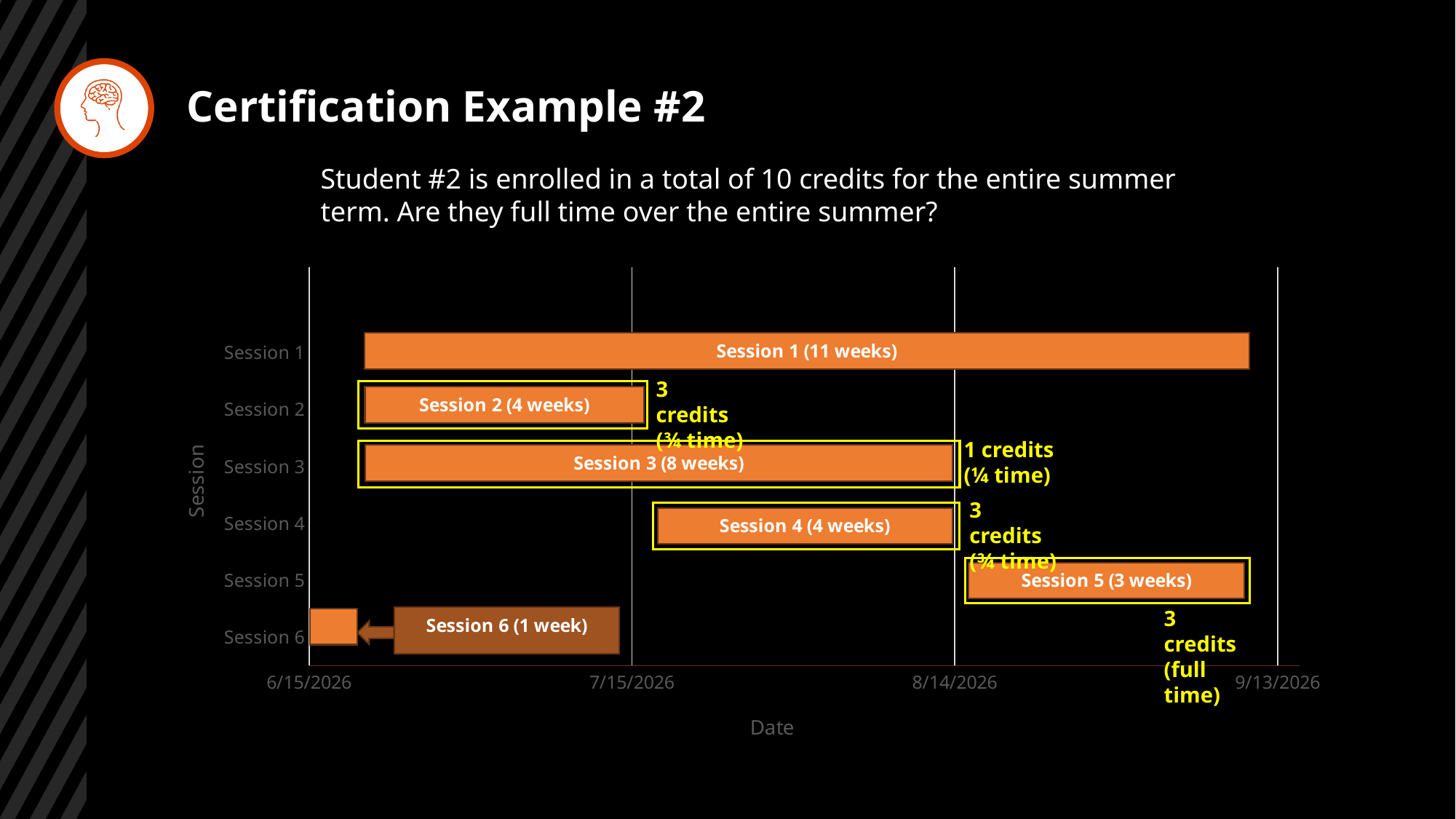
How many weeks long is Session 1 according to its bar label? 11 weeks Which session has the shortest duration? Session 6 Which session has the longest duration? Session 1 How many weeks longer is Session 1 than Session 3? 3 weeks What is the label of the horizontal axis of the chart? Date How many weeks longer is Session 3 than Session 4? 4 weeks Which is longer, Session 2 or Session 5? Session 2 How many weeks long is Session 5? 3 weeks How many credits is the student enrolled in for Session 3, according to the annotation? 1 credits (¼ time) How many sessions are shown on the chart? 6 What kind of chart is shown on the slide? Bar chart How many weeks long is Session 3? 8 weeks